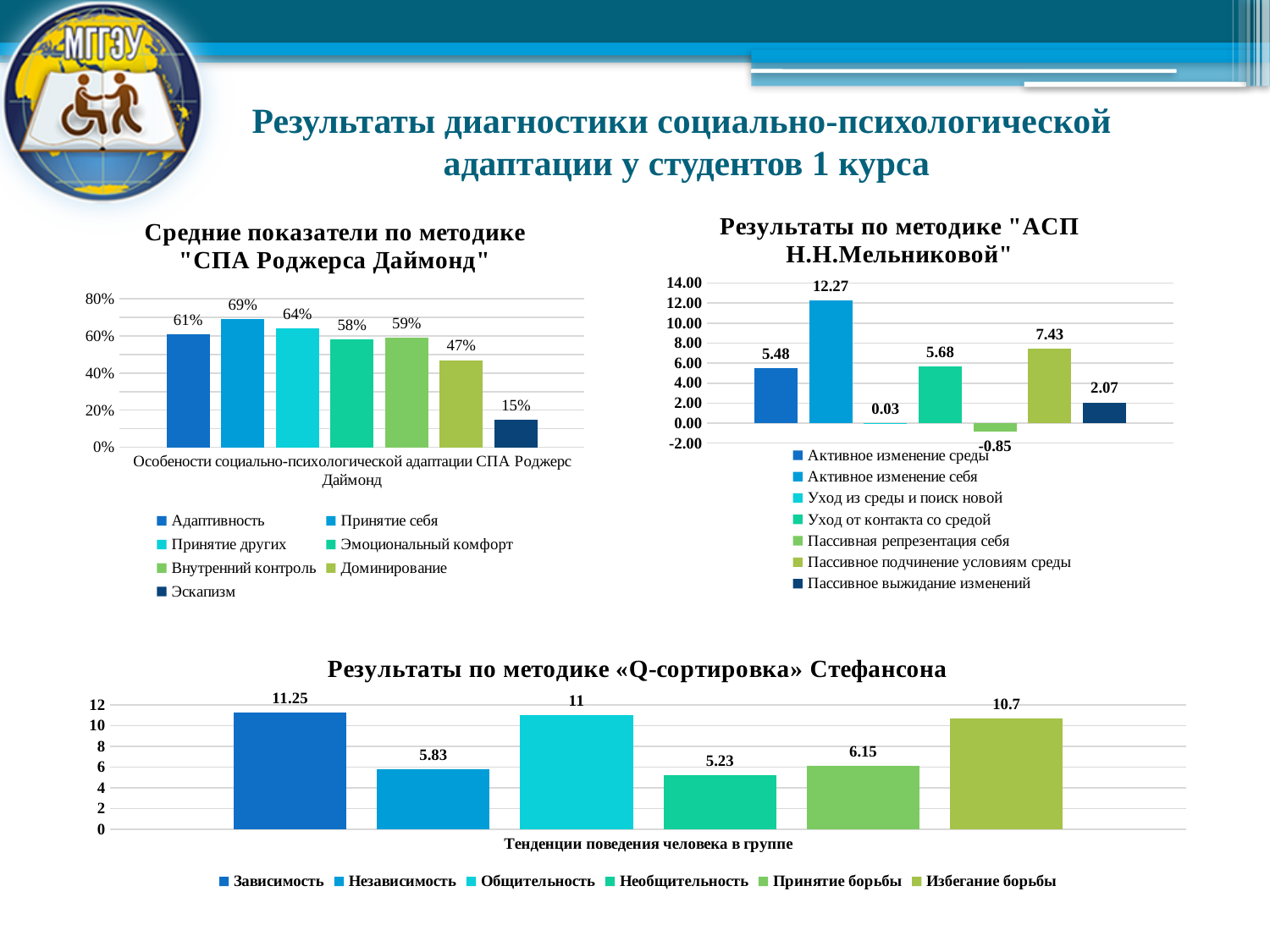
How many series does the legend of the chart "Результаты по методике «Q-сортировка» Стефансона" list? 6 In the chart "Результаты по методике "АСП Н.Н.Мельниковой"", what is the value for Пассивная репрезентация себя? -0.85 In the chart "Результаты по методике "АСП Н.Н.Мельниковой"", what is the value for Пассивное подчинение условиям среды? 7.43 How many series does the legend of the chart "Средние показатели по методике "СПА Роджерса Даймонд"" list? 7 In the chart "Средние показатели по методике "СПА Роджерса Даймонд"", what is the difference between Адаптивность and Доминирование? 14% In the chart "Результаты по методике "АСП Н.Н.Мельниковой"", which is larger: Активное изменение среды or Уход от контакта со средой? Уход от контакта со средой In the chart "Результаты по методике «Q-сортировка» Стефансона", which series has the lowest value? Необщительность In the chart "Результаты по методике «Q-сортировка» Стефансона", what is the value for Избегание борьбы? 10.7 In the chart "Результаты по методике "АСП Н.Н.Мельниковой"", which series has the highest value? Активное изменение себя In the chart "Средние показатели по методике "СПА Роджерса Даймонд"", which series has the lowest value? Эскапизм What kind of chart is "Результаты по методике «Q-сортировка» Стефансона"? Bar chart In the chart "Средние показатели по методике "СПА Роджерса Даймонд"", what is the value for Принятие себя? 69%